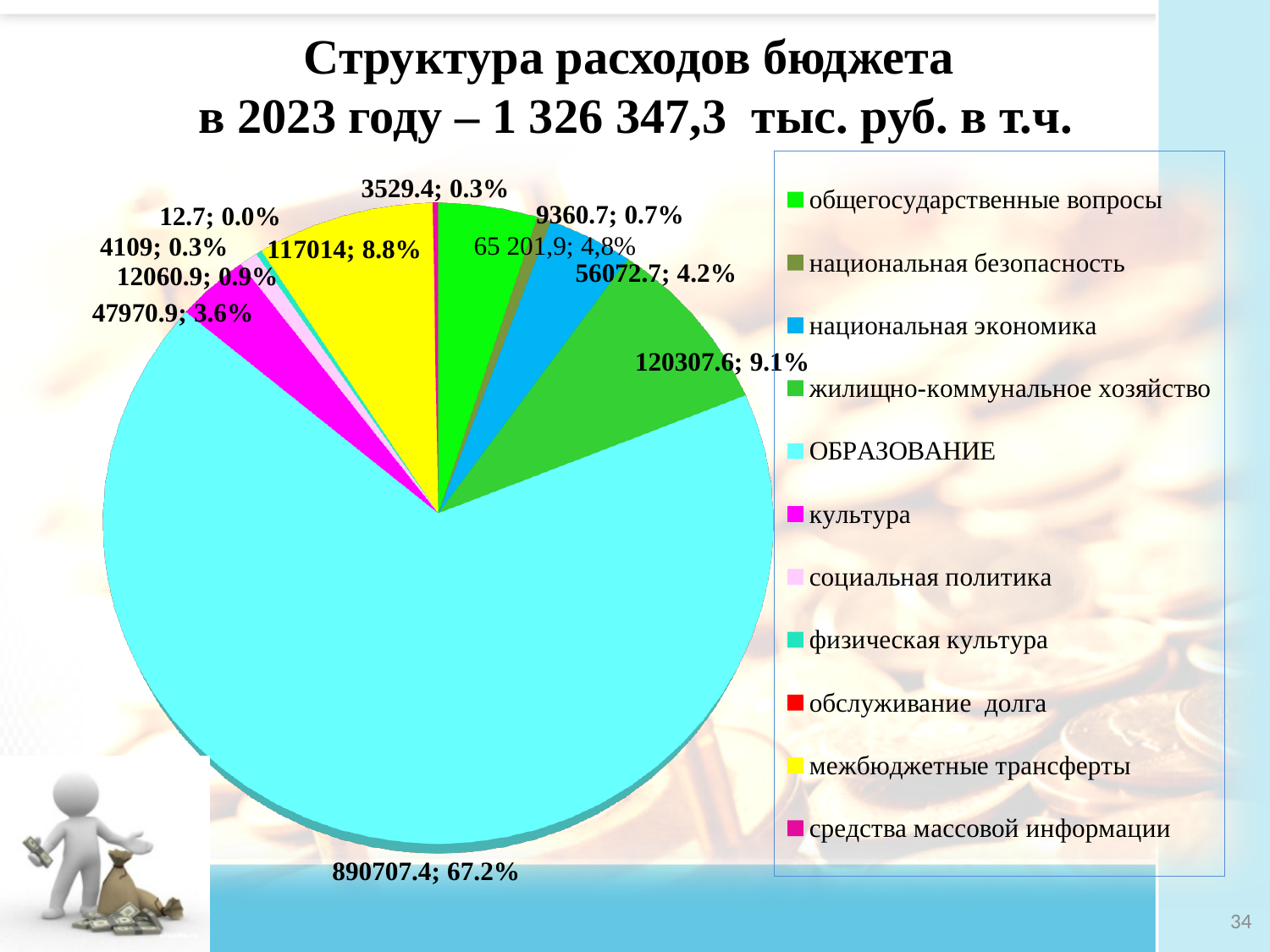
What share of the pie does жилищно-коммунальное хозяйство account for? 9.1% What total amount is stated in the chart title for budget expenditures in 2023? 1 326 347,3 тыс. руб. What value is shown for the ОБРАЗОВАНИЕ slice? 890707.4 What value is shown for the обслуживание долга slice? 12.7 What value is shown for the межбюджетные трансферты slice? 117014 What is the difference between the value for национальная экономика (56072.7) and the value for культура (47970.9)? 8101.8 What share of the pie does ОБРАЗОВАНИЕ account for? 67.2% Which is larger: the value for жилищно-коммунальное хозяйство or the value for межбюджетные трансферты? жилищно-коммунальное хозяйство Which category has the largest share of the pie? ОБРАЗОВАНИЕ Which category has the smallest share of the pie? обслуживание долга How many categories does the legend of the pie chart list? 11 What type of chart is shown on the slide? pie chart